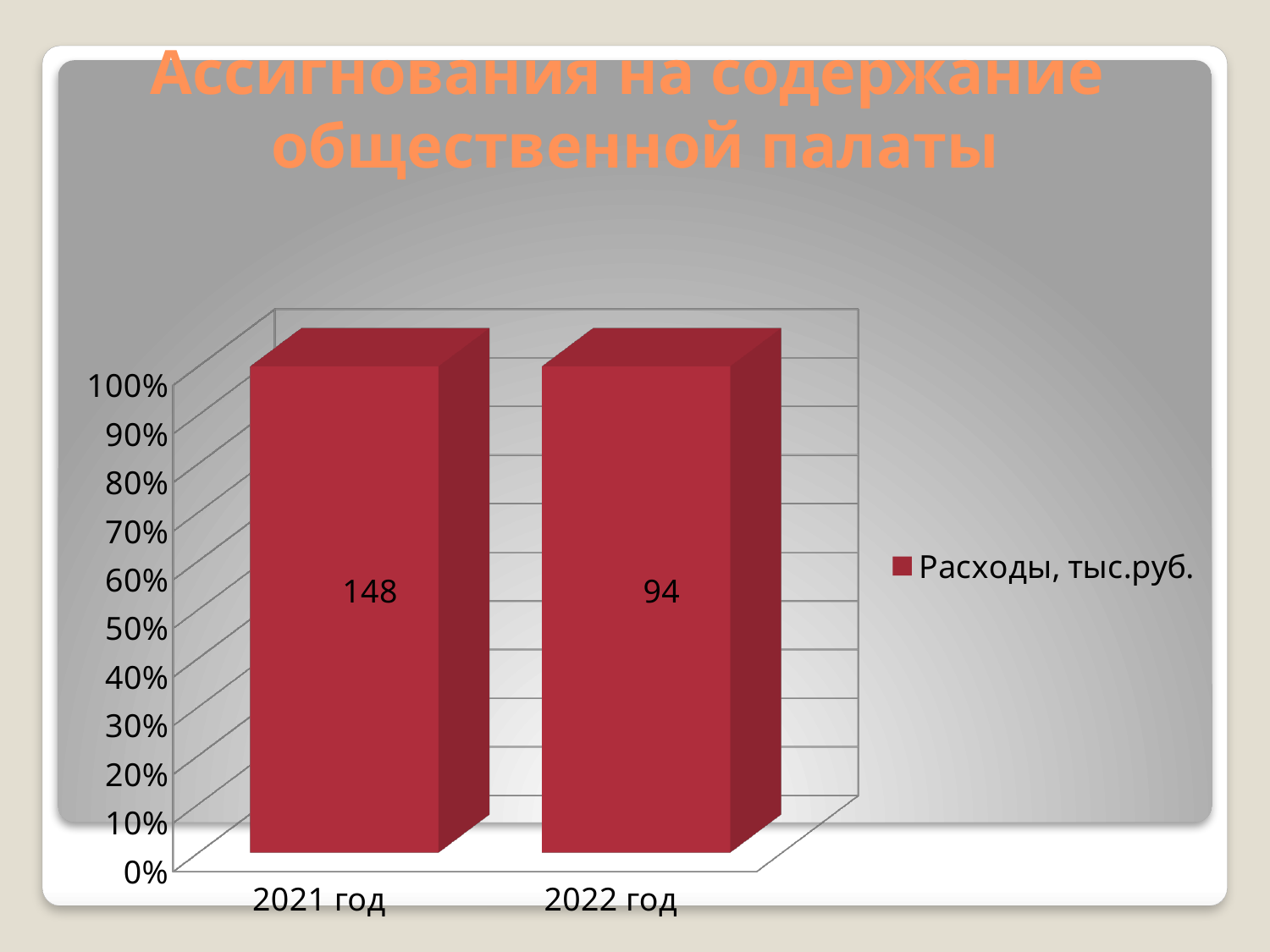
Which category has the highest labelled value? 2021 год What is the difference between the labelled values for 2021 год and 2022 год? 54 Do the labelled values rise or fall from 2021 год to 2022 год? fall What is the data label on the bar for 2021 год? 148 How many series does the legend list? 1 How many categories are shown on the x axis? 2 What series name is shown in the legend? Расходы, тыс.руб. What kind of chart is shown on the slide? bar chart Which category has the lowest labelled value? 2022 год Which year has the higher labelled value, 2021 год or 2022 год? 2021 год What is the data label on the bar for 2022 год? 94 What is the title of the chart? Ассигнования на содержание общественной палаты